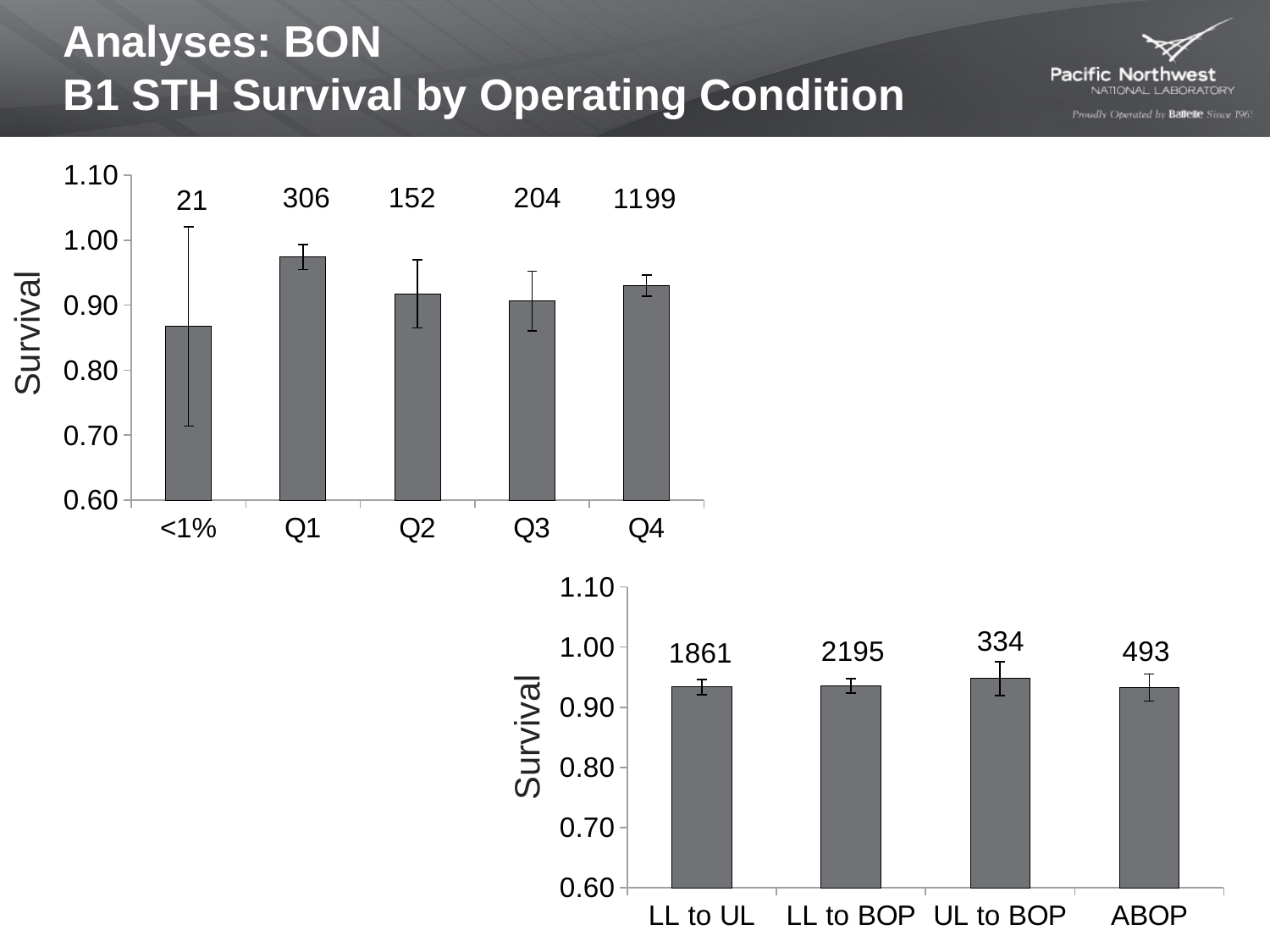
How many categories are shown on the x axis of the top chart? 5 In the bottom chart, what number is printed above the bar for UL to BOP? 334 What kind of chart is the top chart on the slide? bar chart In the top chart, is the survival value for <1% greater or less than 0.90? less In the top chart, which category has the lowest survival bar? <1% In the top chart, what number is printed above the bar for Q4? 1199 In the bottom chart, is the survival value for ABOP greater or less than 0.90? greater In the top chart, what number is printed above the bar for <1%? 21 In the top chart, which has the larger survival bar, Q1 or Q3? Q1 In the bottom chart, what number is printed above the bar for LL to BOP? 2195 How many categories are shown on the x axis of the bottom chart? 4 In the top chart, which category has the highest survival bar? Q1